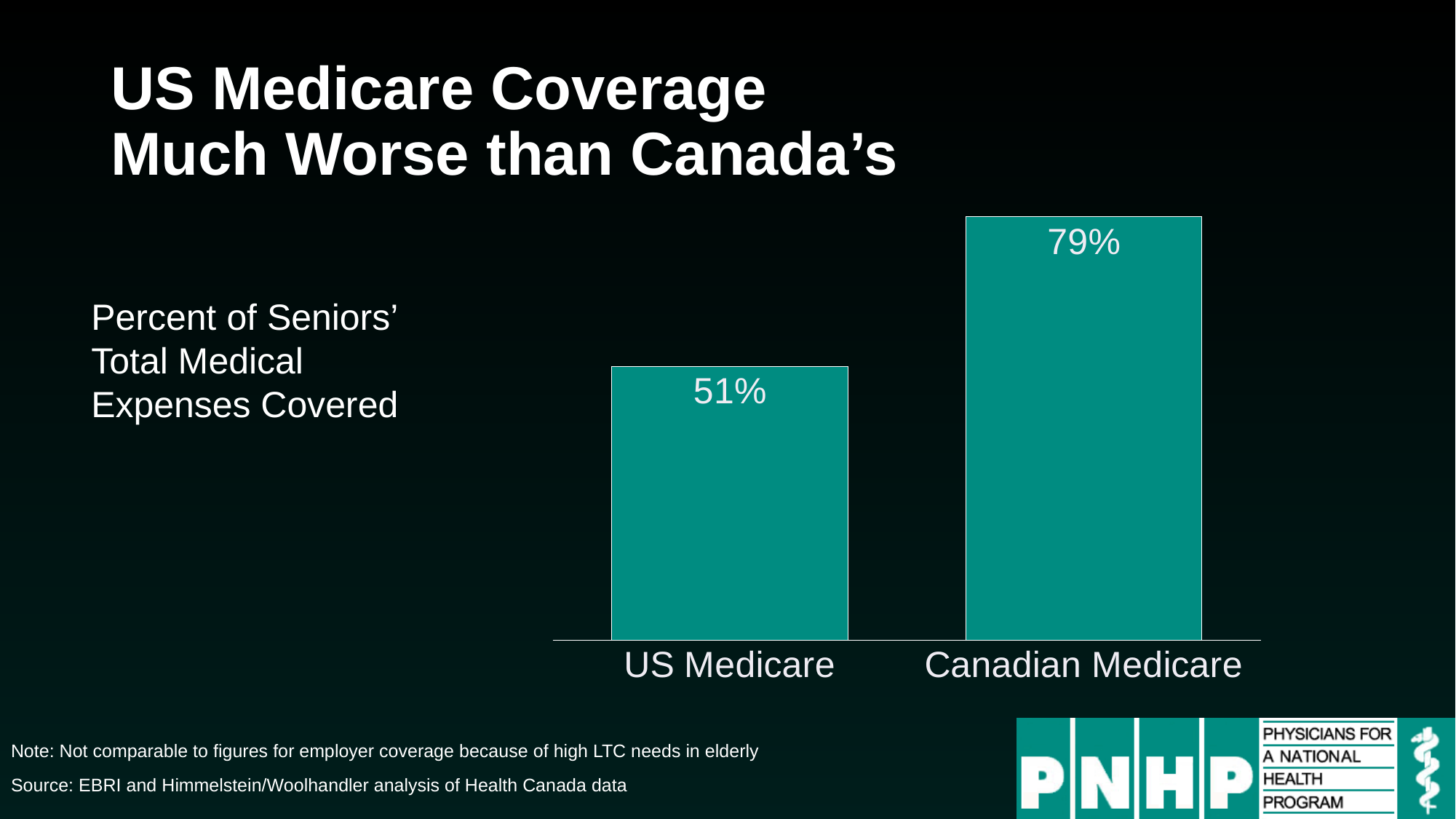
How many categories are shown in the chart? 2 What kind of chart is shown on the slide? bar chart What is the title of the slide? US Medicare Coverage Much Worse than Canada's Which category has the lowest value in the chart? US Medicare Do the values rise or fall from left to right across the chart? rise What quantity does the chart measure, according to the label to the left of the bars? Percent of Seniors' Total Medical Expenses Covered Which category has the higher value, US Medicare or Canadian Medicare? Canadian Medicare What is the difference between the Canadian Medicare and US Medicare values? 28% Is the value for US Medicare larger or smaller than the value for Canadian Medicare? smaller What percent of seniors' total medical expenses does Canadian Medicare cover? 79% What percent of seniors' total medical expenses does US Medicare cover? 51%